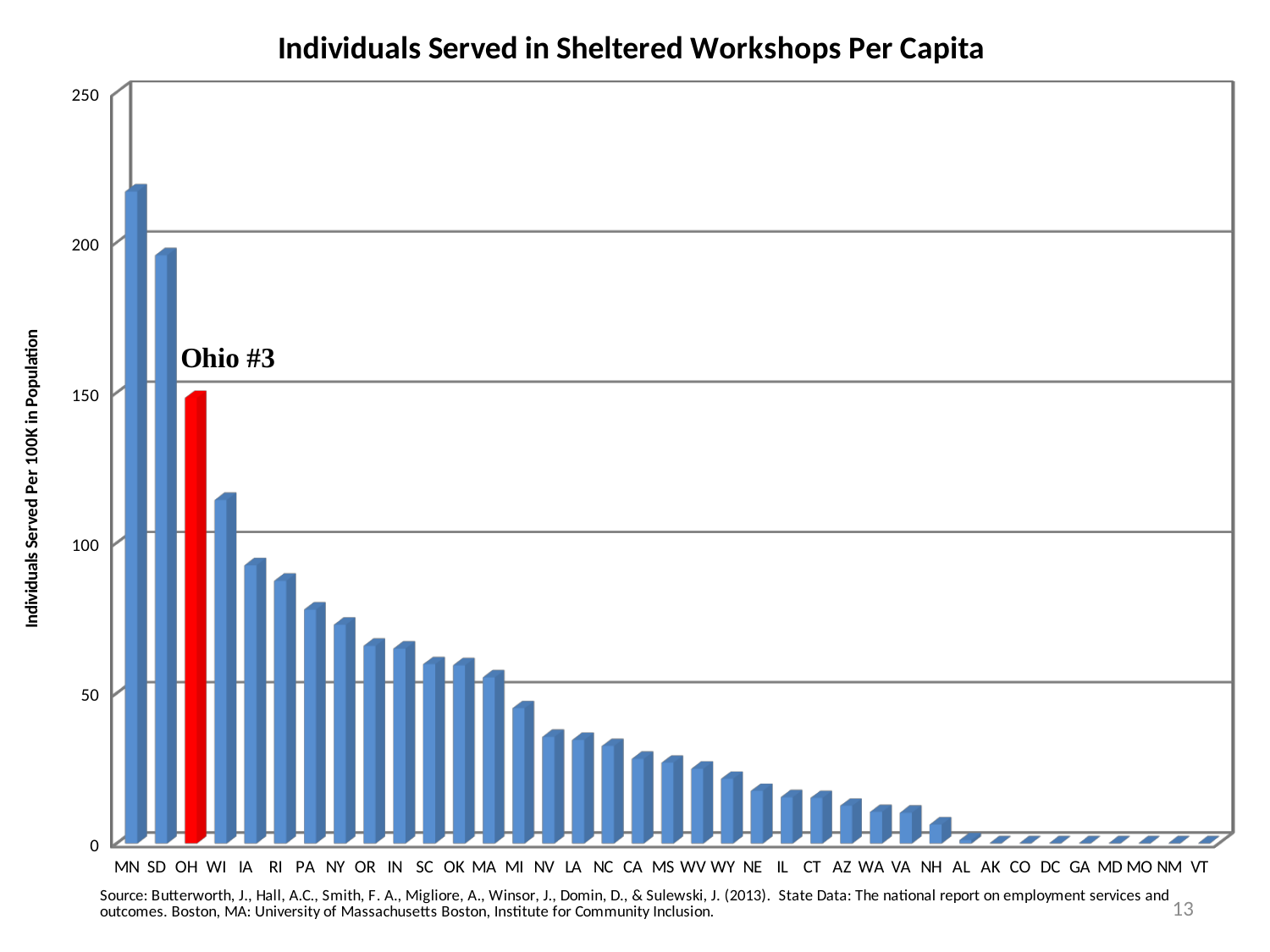
Is the value for IA greater or less than 100? less Is the value for WI greater or less than 100? greater How many states or categories are shown along the x axis? 37 Which state has the highest value in the chart? MN Is the value for MN greater or less than 200? greater Which has a larger value, WI or IA? WI Which state's bar is highlighted in red? OH Which has a larger value, MN or SD? MN Do the values rise or fall moving from left to right along the x axis? fall What kind of chart is shown on the slide? bar chart What is the title of the chart? Individuals Served in Sheltered Workshops Per Capita